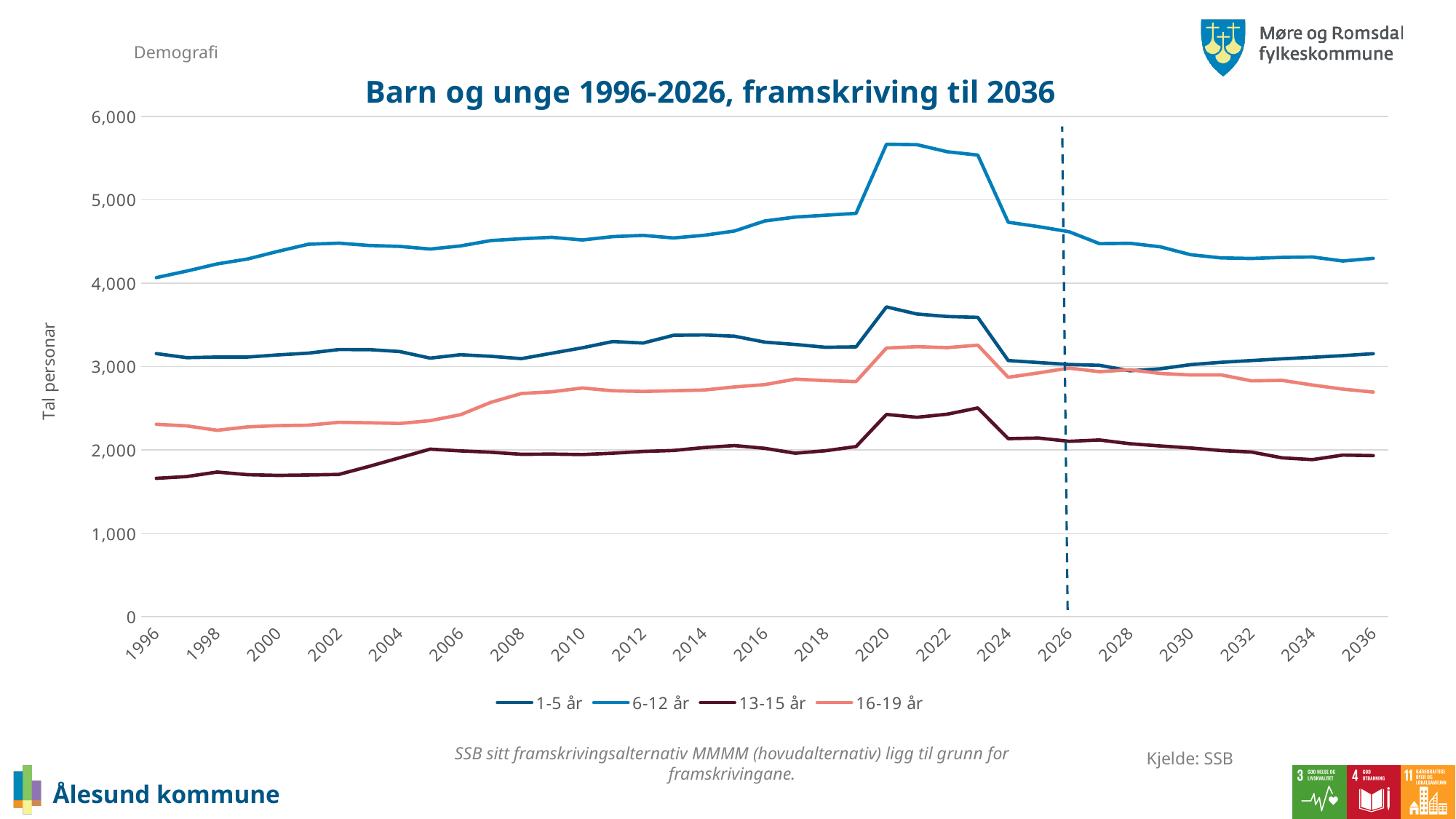
What kind of chart is shown on the slide? line chart Is the value for 16-19 år in 2010 greater or less than 3,000? less Does the 6-12 år series rise or fall from 2024 to 2036? fall Is the value for 6-12 år in 2020 greater or less than 5,000? greater In 2036, which is larger: the value for 1-5 år or the value for 16-19 år? 1-5 år Which age group has the lowest values across the whole period? 13-15 år What is the title of the chart? Barn og unge 1996-2026, framskriving til 2036 Is the value for 13-15 år in 1996 greater or less than 2,000? less Which year does the dashed vertical line on the chart mark? 2026 Which age group has the highest values across the whole period? 6-12 år How many series does the legend list? 4